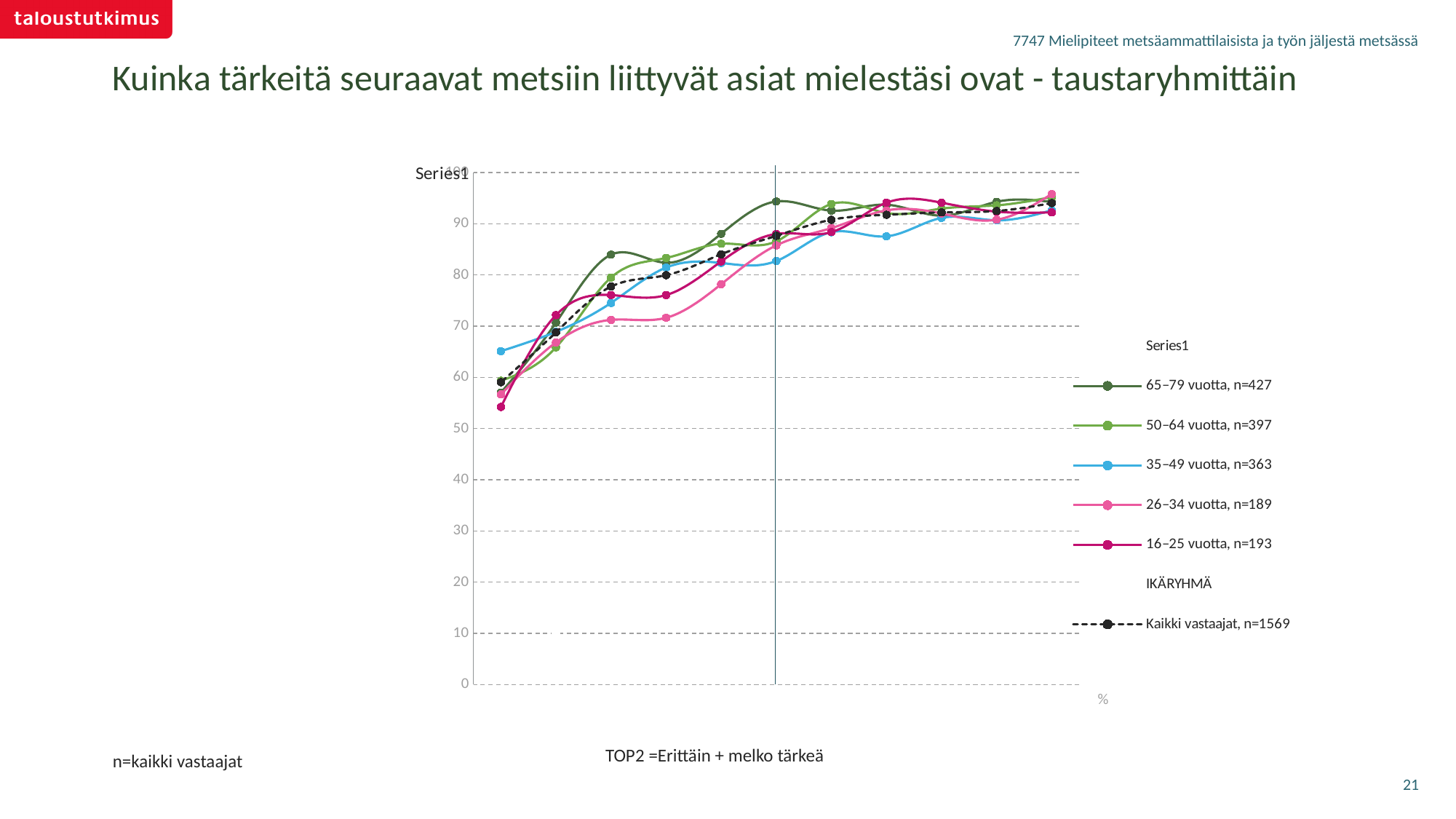
Is the leftmost value for the 16–25 vuotta series greater or less than 50? greater Is the leftmost value for the 26–34 vuotta series greater or less than 60? less Is the rightmost value for the 65–79 vuotta series greater or less than 90? greater At the leftmost point, which series has the higher value: 35–49 vuotta or 16–25 vuotta? 35–49 vuotta How many data points does each line in the chart have? 11 What sample size (n) is given in the legend for the 65–79 vuotta series? n=427 Which series in the legend is drawn with a dashed black line? Kaikki vastaajat, n=1569 Do the values of the lines generally rise or fall from left to right along the x axis? rise What kind of chart is shown on the slide? line chart